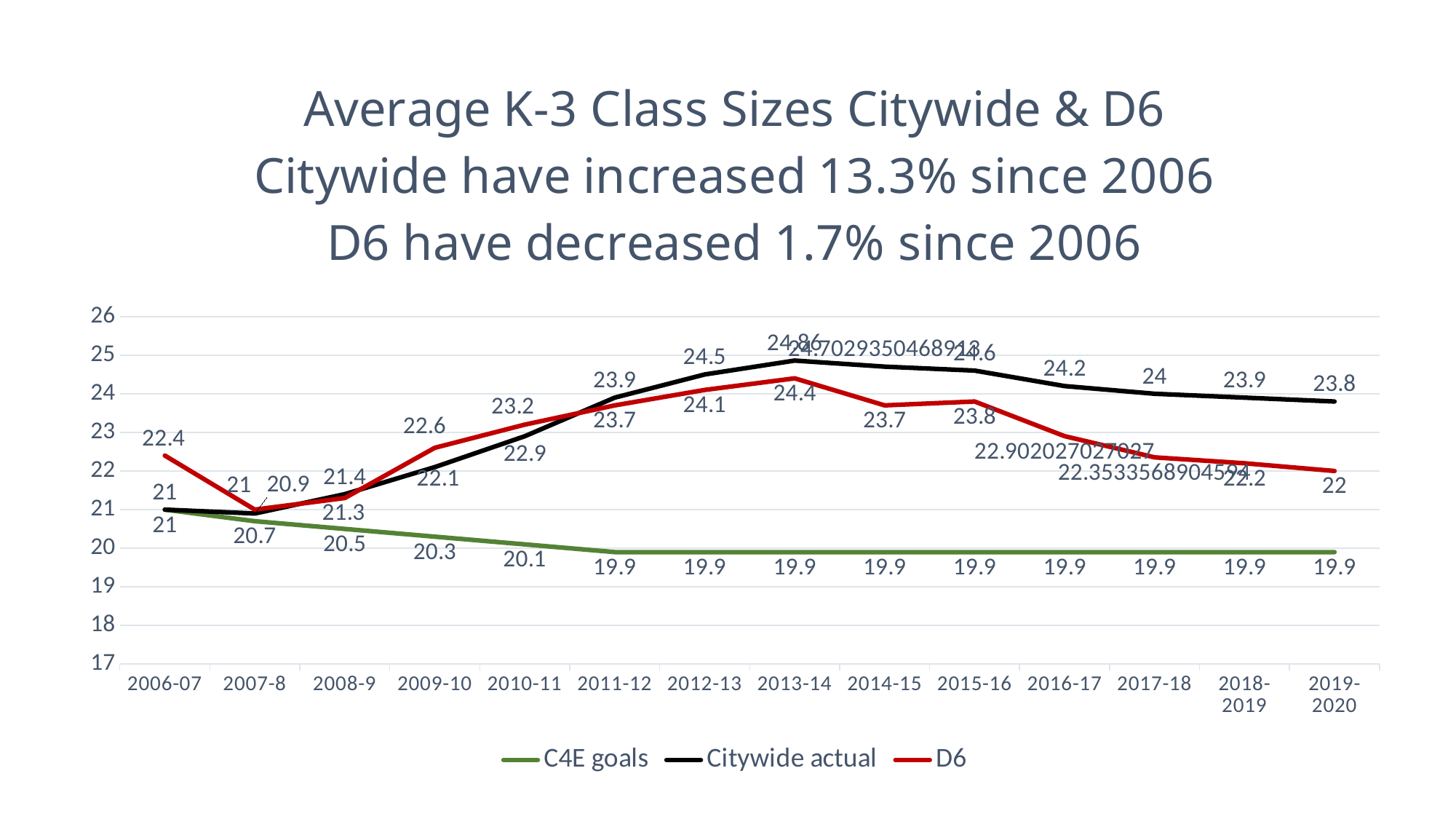
What kind of chart is shown on the slide? line chart How many school years are plotted along the x axis? 14 What is the Citywide actual value for 2019-2020? 23.8 What is the C4E goals value for 2019-2020? 19.9 What is the D6 value for 2006-07? 22.4 What colour is the D6 line? red In 2012-13, which is larger: Citywide actual or D6? Citywide actual In which school year is the D6 value lowest? 2007-8 How many series does the legend list? 3 Do the C4E goals values rise or fall from 2006-07 to 2019-2020? fall What is the Citywide actual value for 2017-18? 24 What is the difference between the Citywide actual and D6 values in 2019-2020? 1.8